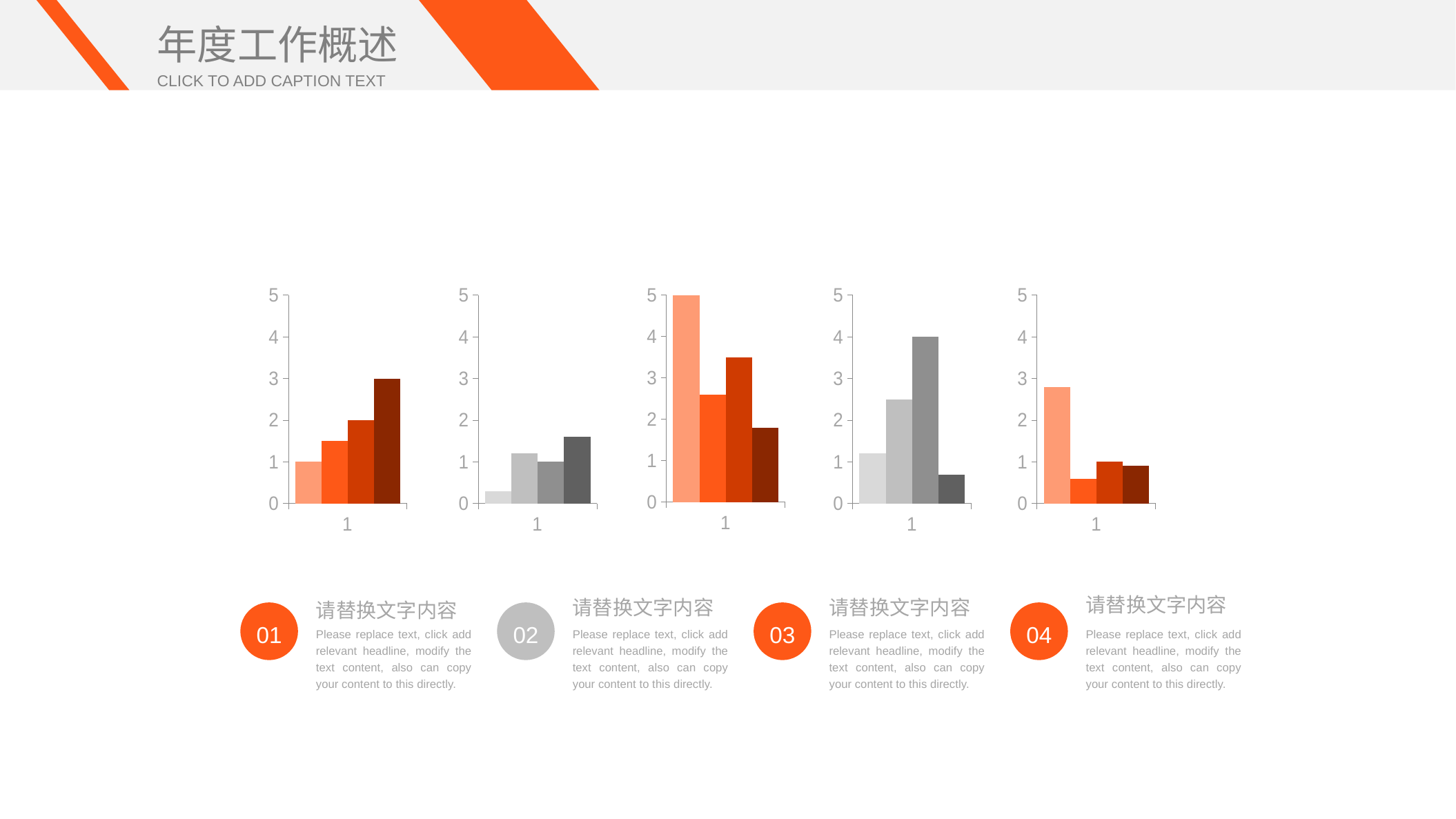
In the middle chart, which bar is the shortest? the fourth (darkest) bar In the second chart from the left, is the value of the first bar greater or less than 1? less What kind of chart is the leftmost chart on the slide? bar chart In the fourth chart from the left, is the value of the second bar greater or less than 2? greater In the leftmost chart, do the bar heights rise or fall from left to right? rise In the fourth chart from the left, what is the value of the tallest bar? 4 In the rightmost chart, which bar is the tallest? the first (lightest) bar In the leftmost chart, what is the value of the tallest (darkest) bar? 3 In the leftmost chart, what is the value of the first (lightest) bar? 1 How many bars does the leftmost chart show? 4 In the middle chart, what is the value of the first (lightest) bar? 5 In the rightmost chart, is the value of the first bar greater or less than 2? greater